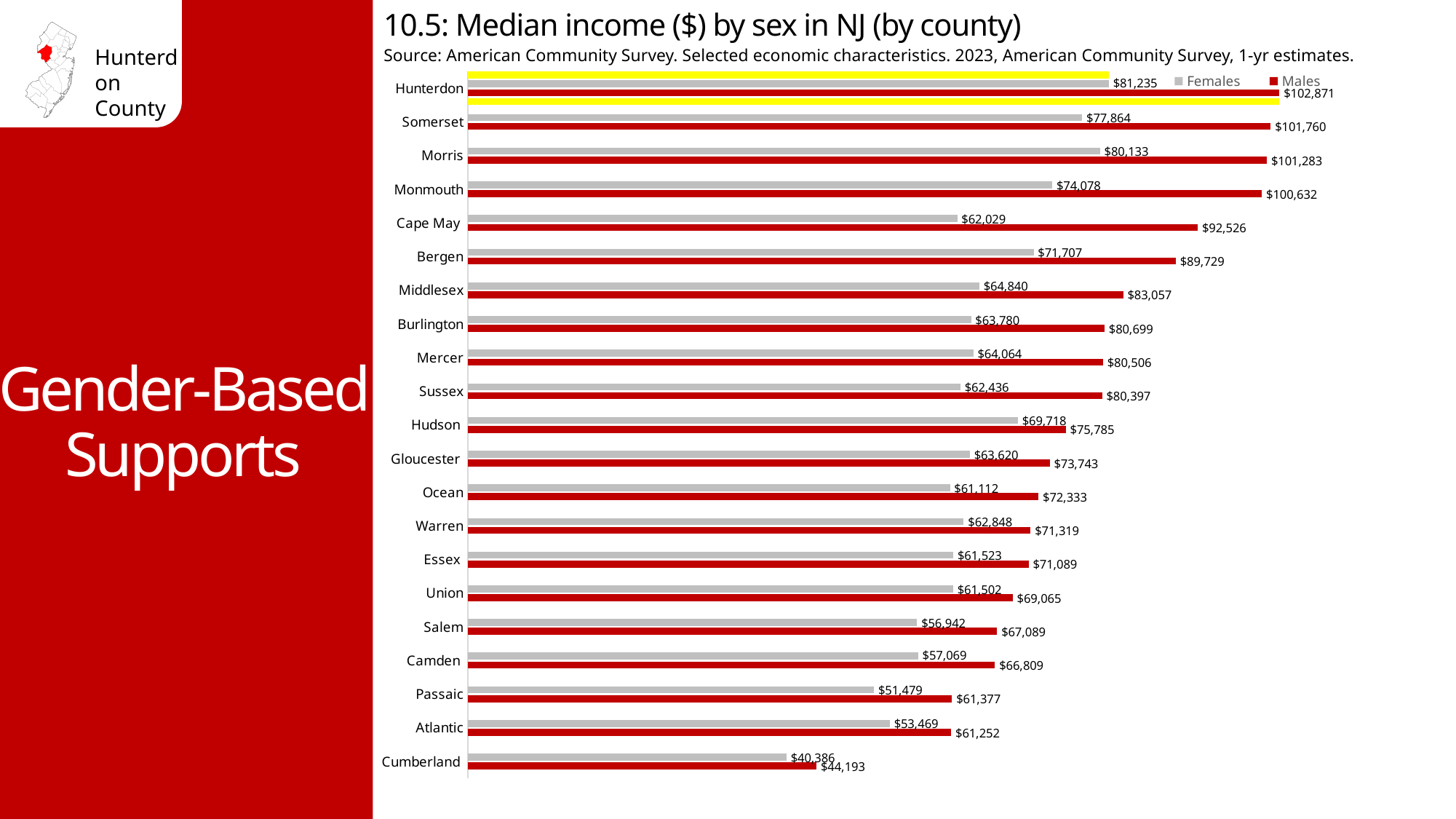
What is the median income for females in Somerset County? $77,864 Which is larger, the female median income in Morris County or in Monmouth County? Morris What is the median income for males in Cape May County? $92,526 What is the difference between the male and female median incomes in Hunterdon County? $21,636 What is the median income for males in Hunterdon County? $102,871 Which county has the highest median income for males? Hunterdon How many counties are shown in the chart? 21 How many series does the legend list? 2 What is the median income for females in Cumberland County? $40,386 Which county has the lowest median income for females? Cumberland What kind of chart is shown on the slide? Bar chart What is the difference between the male and female median incomes in Cumberland County? $3,807